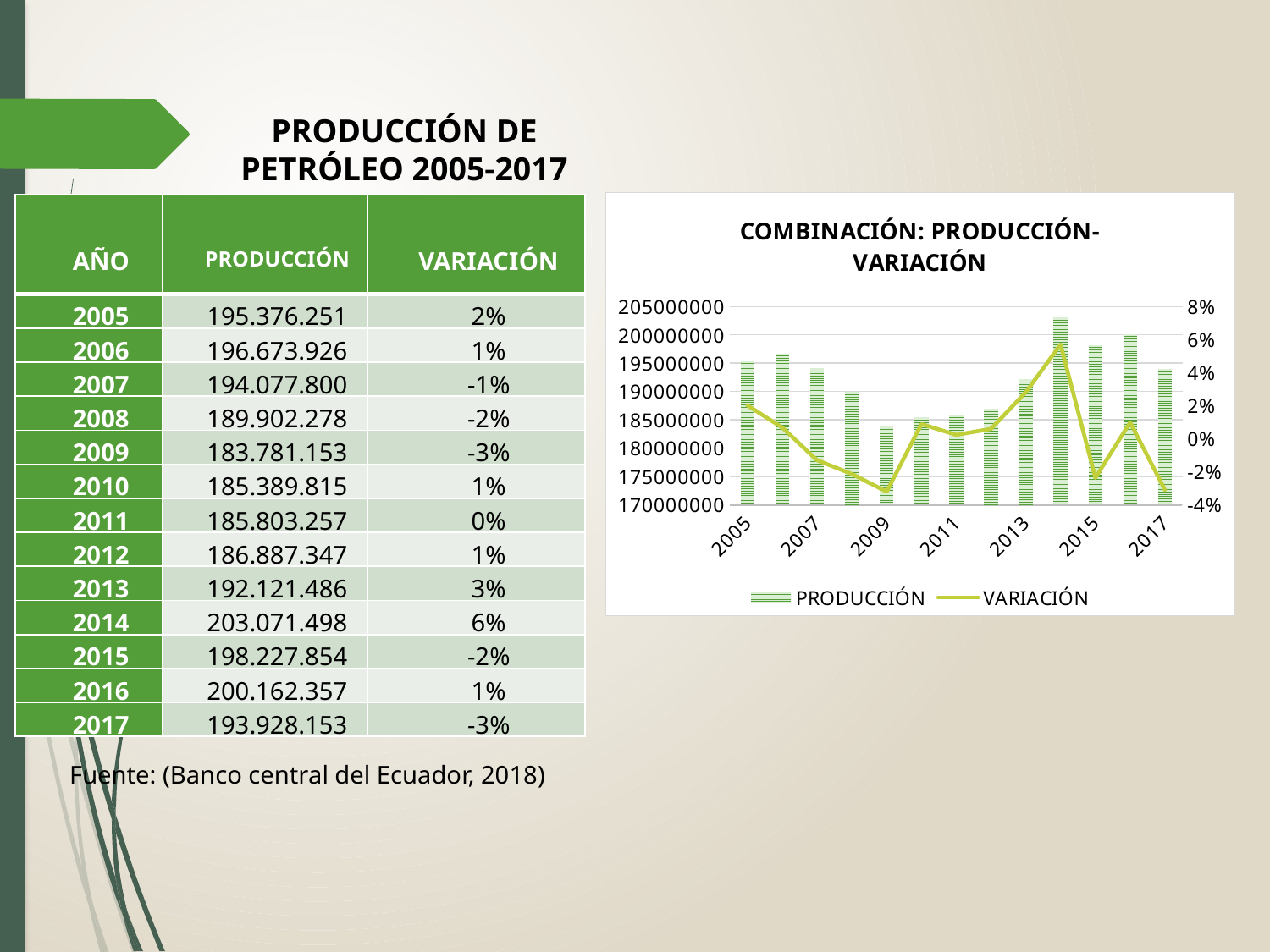
Does the VARIACIÓN line rise or fall from 2014 to 2015? fall Is the PRODUCCIÓN value for 2009 greater or less than 185000000? less What is the difference in PRODUCCIÓN between 2014 and 2015? 4.843.644 What is the PRODUCCIÓN value for 2014? 203.071.498 Which year has the lowest PRODUCCIÓN bar? 2009 Is the PRODUCCIÓN value for 2014 greater or less than 200000000? greater How many series does the chart legend list? 2 Which year has the highest PRODUCCIÓN bar? 2014 Which year has the larger PRODUCCIÓN value, 2005 or 2009? 2005 What kind of chart is shown on the slide? A combination bar and line chart What is the VARIACIÓN value for 2014? 6% How many years are plotted on the chart's x axis? 13